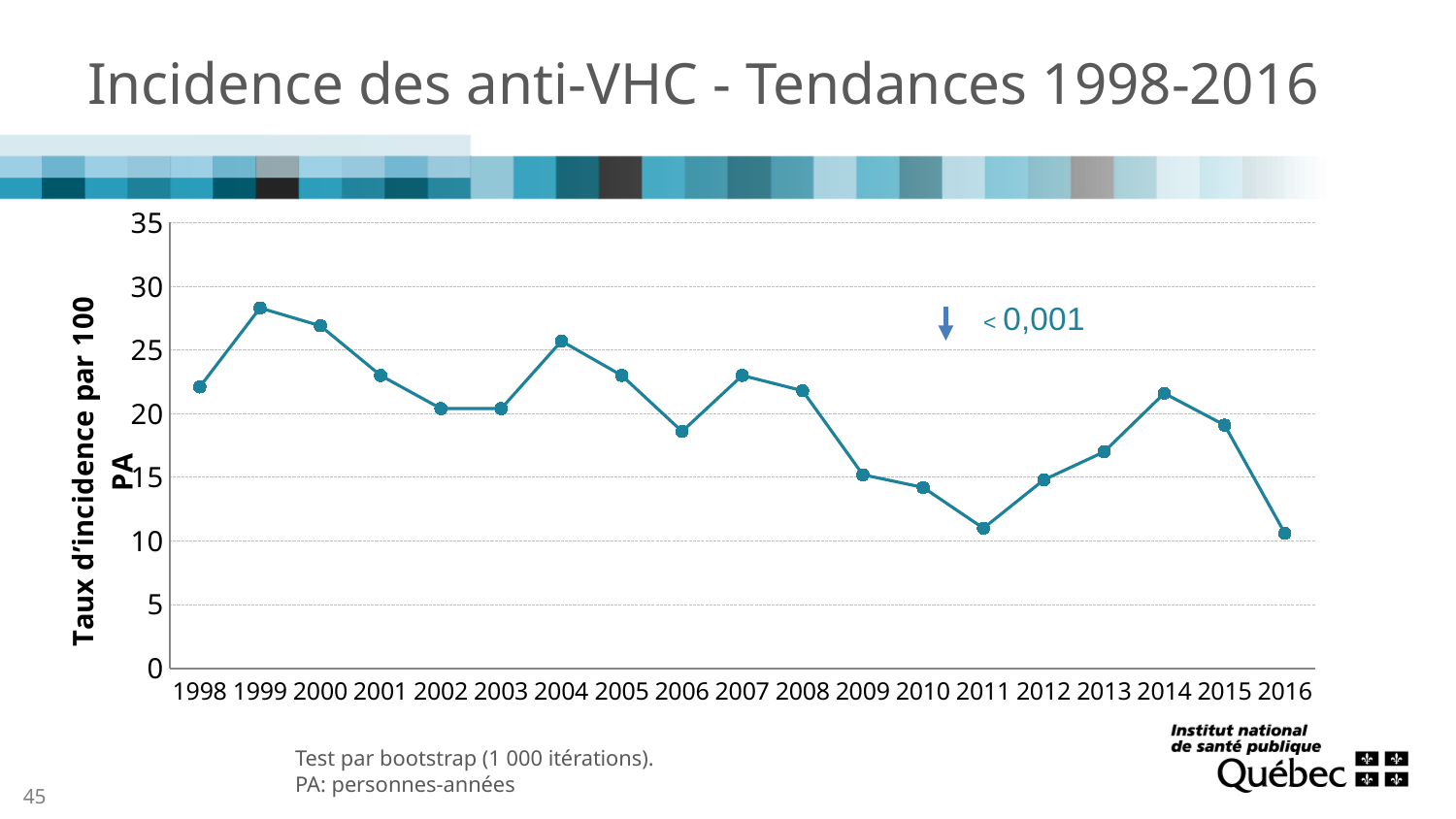
Which is larger, the value for 2004 or the value for 2006? 2004 Is the value for 2011 greater or less than 15? less What is the y-axis title of the chart? Taux d'incidence par 100 PA Which is larger, the value for 1999 or the value for 2016? 1999 Is the value for 1999 greater or less than 25? greater Overall, do the values rise or fall from 1998 to 2016? fall How many years are plotted along the x axis? 19 Is the value for 2016 greater or less than 15? less Which year has the highest incidence rate? 1999 What kind of chart is shown on the slide? line chart